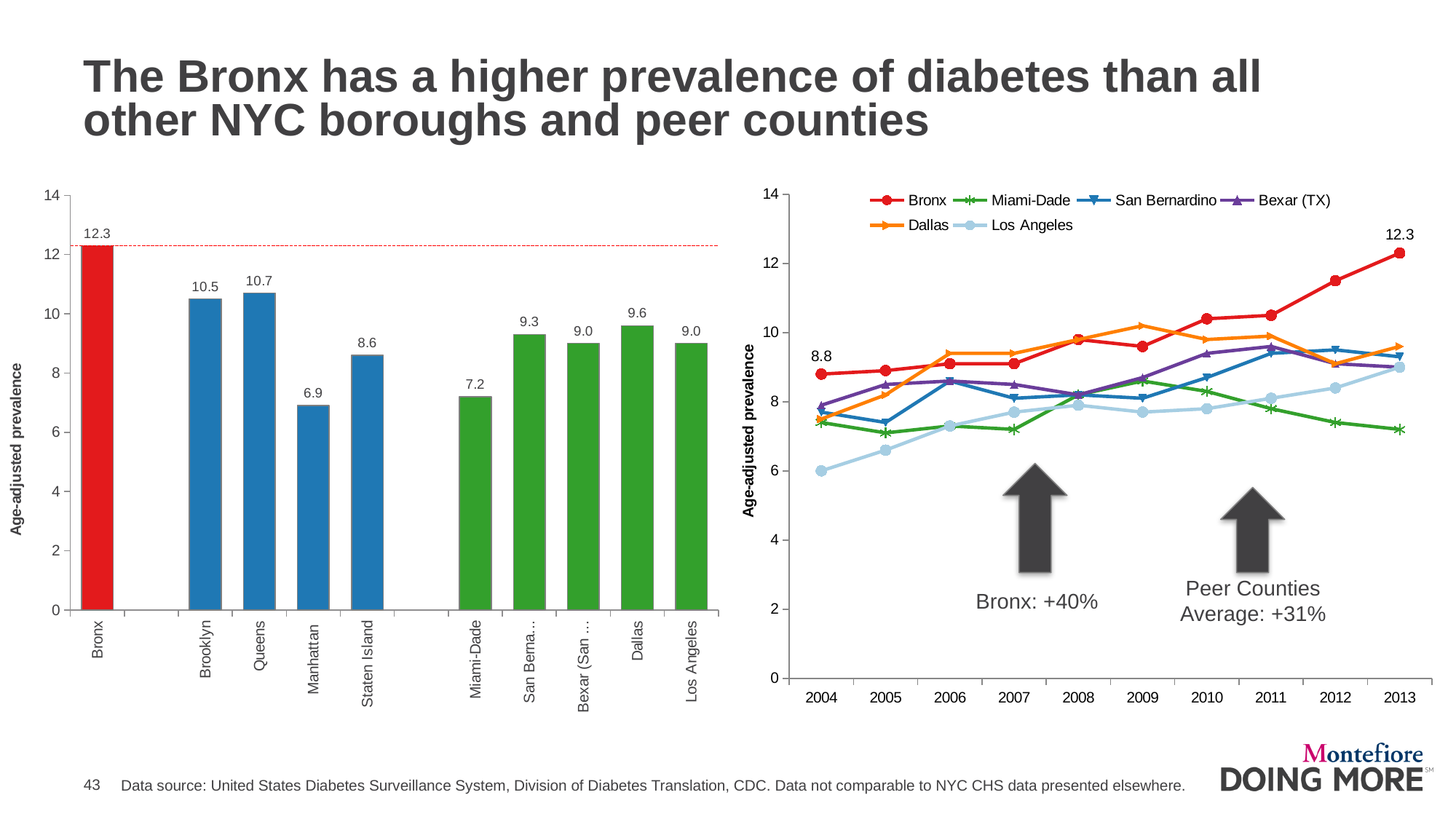
What kind of chart is the chart on the left of the slide? bar chart In the bar chart on the left, what is the age-adjusted prevalence for Manhattan? 6.9 In the bar chart on the left, what is the age-adjusted prevalence for the Bronx? 12.3 In the bar chart on the left, which is larger, the value for Dallas or the value for Miami-Dade? Dallas In the bar chart on the left, what is the difference between the values for Queens and Brooklyn? 0.2 How many series does the legend of the line chart on the right list? 6 In the bar chart on the left, which category has the highest value? Bronx In the bar chart on the left, which category has the lowest value? Manhattan In the line chart on the right, is the Los Angeles value in 2004 greater or less than 8? less How many bars are in the bar chart on the left? 10 In the line chart on the right, what is the Bronx value in 2004? 8.8 In the line chart on the right, does the Bronx line rise or fall from 2004 to 2013? rise